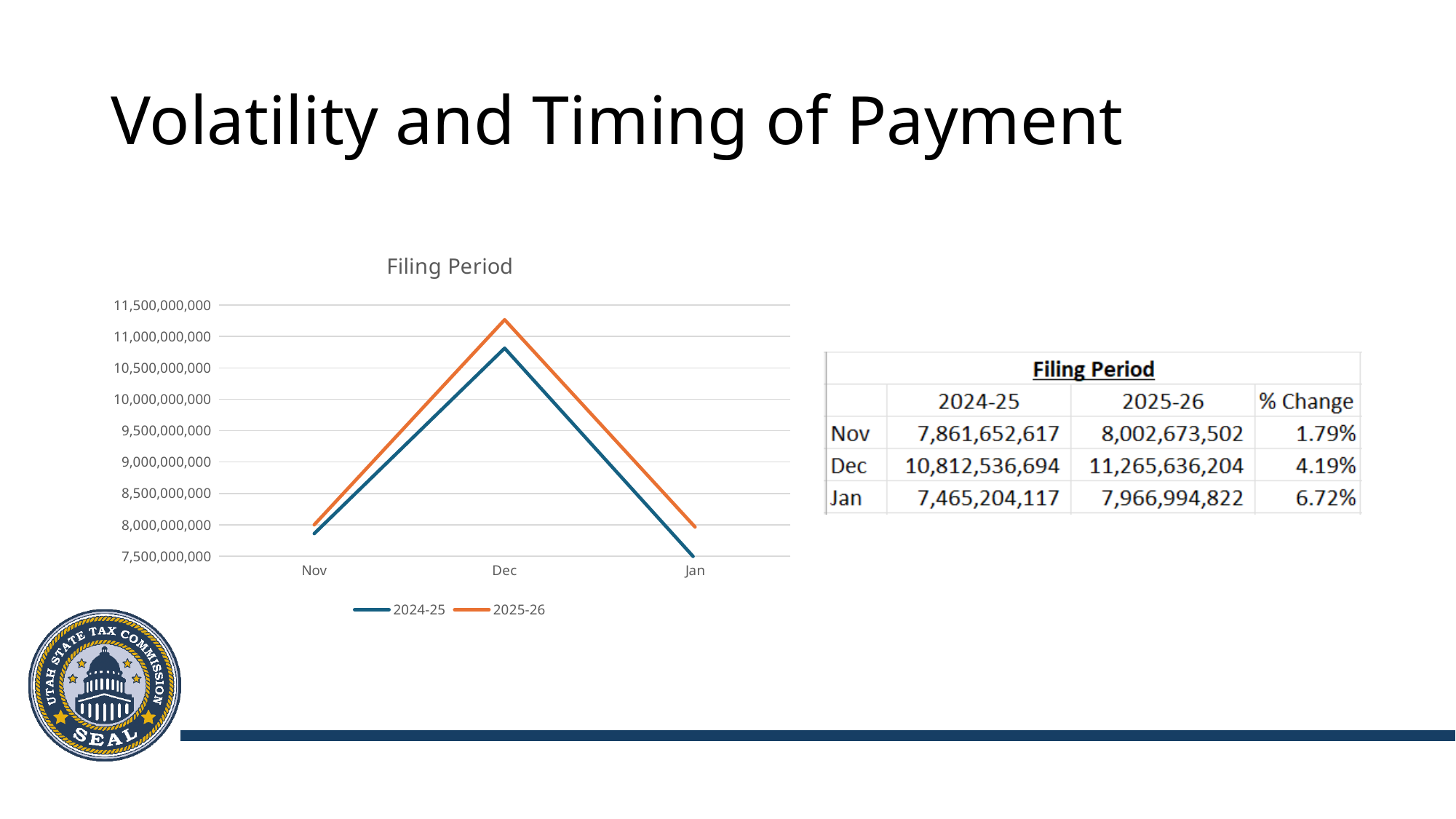
What is the % Change for Jan shown in the table? 6.72% For Dec, which series is higher, 2024-25 or 2025-26? 2025-26 How many series does the legend of the Filing Period chart list? 2 What is the Dec value for the 2025-26 series, as shown in the table on the slide? 11,265,636,204 How many filing periods are plotted along the x axis of the chart? 3 Is the Jan value for 2024-25 greater or less than 8,000,000,000? less In which month is the 2024-25 series at its lowest value? Jan Does the 2024-25 series rise or fall from Dec to Jan? falls What kind of chart is shown on the slide? line chart In which month does the 2025-26 series reach its highest value? Dec Is the Dec value for 2025-26 greater or less than 11,000,000,000? greater What is the difference between the Nov values for 2025-26 and 2024-25, using the figures in the table? 141,020,885